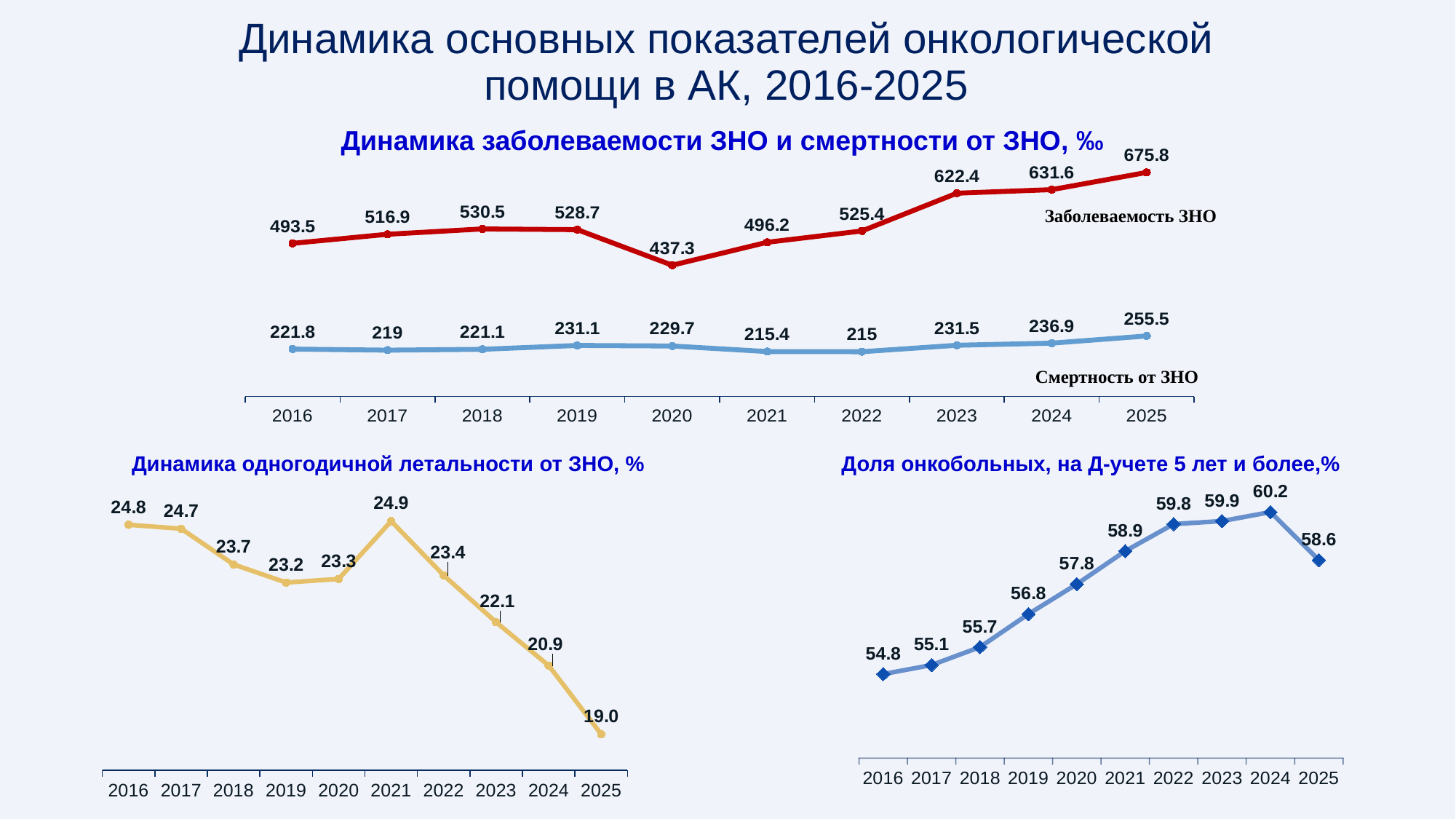
In the chart 'Доля онкобольных, на Д-учете 5 лет и более,%', is the value for 2019 larger or smaller than the value for 2025? smaller In the chart 'Динамика заболеваемости ЗНО и смертности от ЗНО, ‰', what is the difference between Заболеваемость ЗНО in 2025 and in 2016? 182.3 How many series does the chart 'Динамика заболеваемости ЗНО и смертности от ЗНО, ‰' show? 2 In the chart 'Динамика заболеваемости ЗНО и смертности от ЗНО, ‰', what is the value of Смертность от ЗНО in 2025? 255.5 In the chart 'Динамика одногодичной летальности от ЗНО, %', which year has the highest value? 2021 In the chart 'Динамика одногодичной летальности от ЗНО, %', what is the value for 2025? 19.0 In the chart 'Динамика заболеваемости ЗНО и смертности от ЗНО, ‰', in which year is Смертность от ЗНО lowest? 2022 In the chart 'Динамика заболеваемости ЗНО и смертности от ЗНО, ‰', what is the value of Заболеваемость ЗНО in 2020? 437.3 In the chart 'Динамика заболеваемости ЗНО и смертности от ЗНО, ‰', in which year is Заболеваемость ЗНО highest? 2025 In the chart 'Динамика одногодичной летальности от ЗНО, %', what is the difference between the 2021 and 2025 values? 5.9 In the chart 'Доля онкобольных, на Д-учете 5 лет и более,%', which year has the highest value? 2024 What type of chart is 'Доля онкобольных, на Д-учете 5 лет и более,%'? line chart